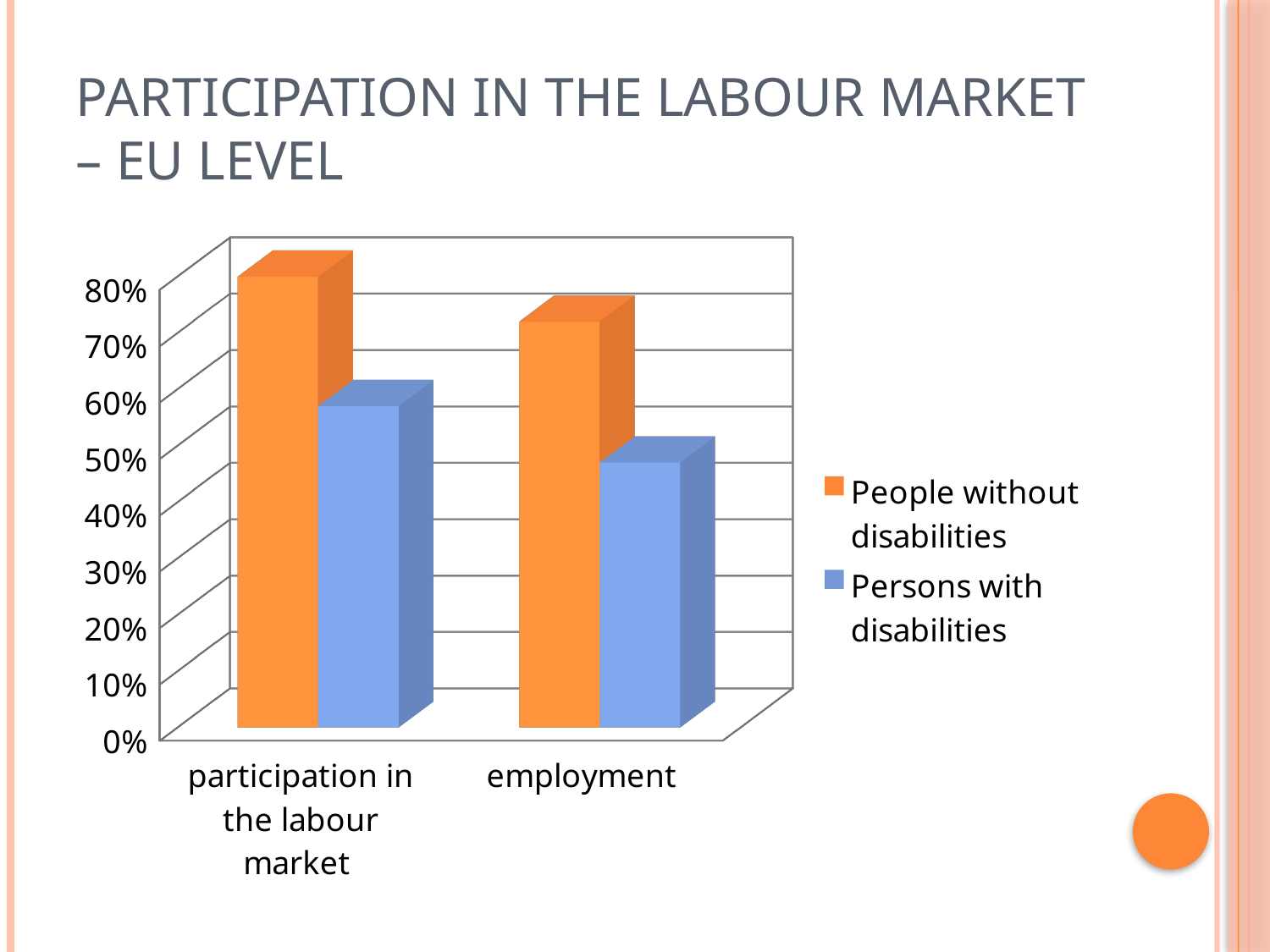
What colour represents Persons with disabilities in the chart? blue Is the value for Persons with disabilities in employment greater or less than 60%? less Is the value for People without disabilities in participation in the labour market greater or less than 70%? greater Which series has the higher value for participation in the labour market? People without disabilities Do the values for People without disabilities rise or fall from participation in the labour market to employment? fall How many series does the chart's legend list? 2 Which category has the highest value for Persons with disabilities? participation in the labour market Which category has the lowest value for People without disabilities? employment Which series has the higher value for employment: People without disabilities or Persons with disabilities? People without disabilities How many categories are shown on the x axis of the chart? 2 What kind of chart is shown on the slide? bar chart Is the value for Persons with disabilities in participation in the labour market greater or less than 50%? greater